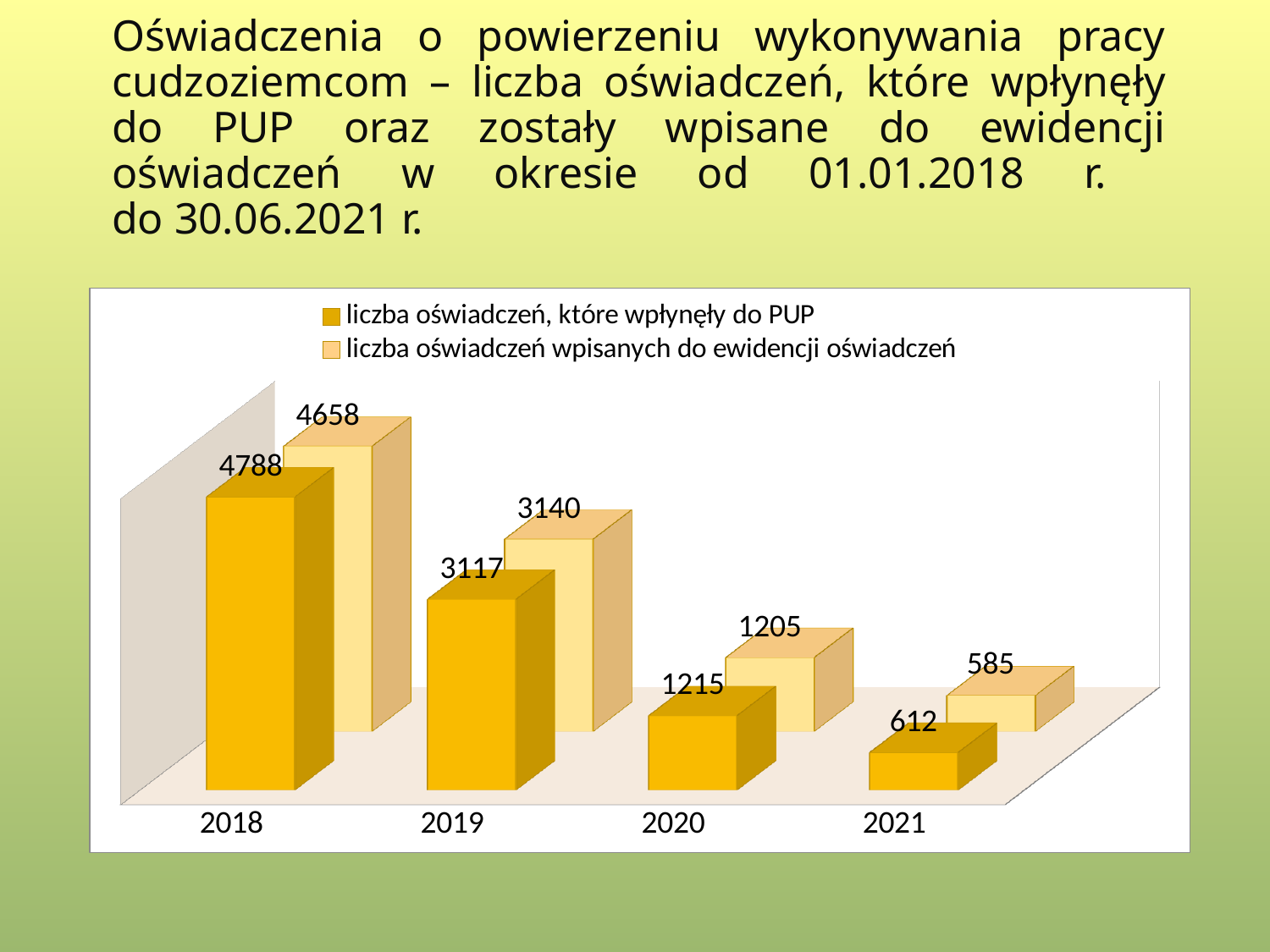
Which is larger in 2020: the number of declarations received by PUP or the number entered into the register? the number of declarations received by PUP (1215) What was the number of declarations received by PUP in 2020? 1215 What is the difference between the number of declarations received by PUP and the number entered into the register in 2018? 130 In which year was the number of declarations entered into the register the lowest? 2021 What is the difference between the number of declarations received by PUP in 2019 and in 2020? 1902 What was the number of declarations received by PUP (liczba oświadczeń, które wpłynęły do PUP) in 2018? 4788 How many years are shown on the x axis of the chart? 4 What was the number of declarations entered into the register in 2021? 585 In which year was the number of declarations received by PUP the highest? 2018 What was the number of declarations entered into the register (liczba oświadczeń wpisanych do ewidencji oświadczeń) in 2019? 3140 What kind of chart is shown on the slide? bar chart How many series does the chart legend list? 2